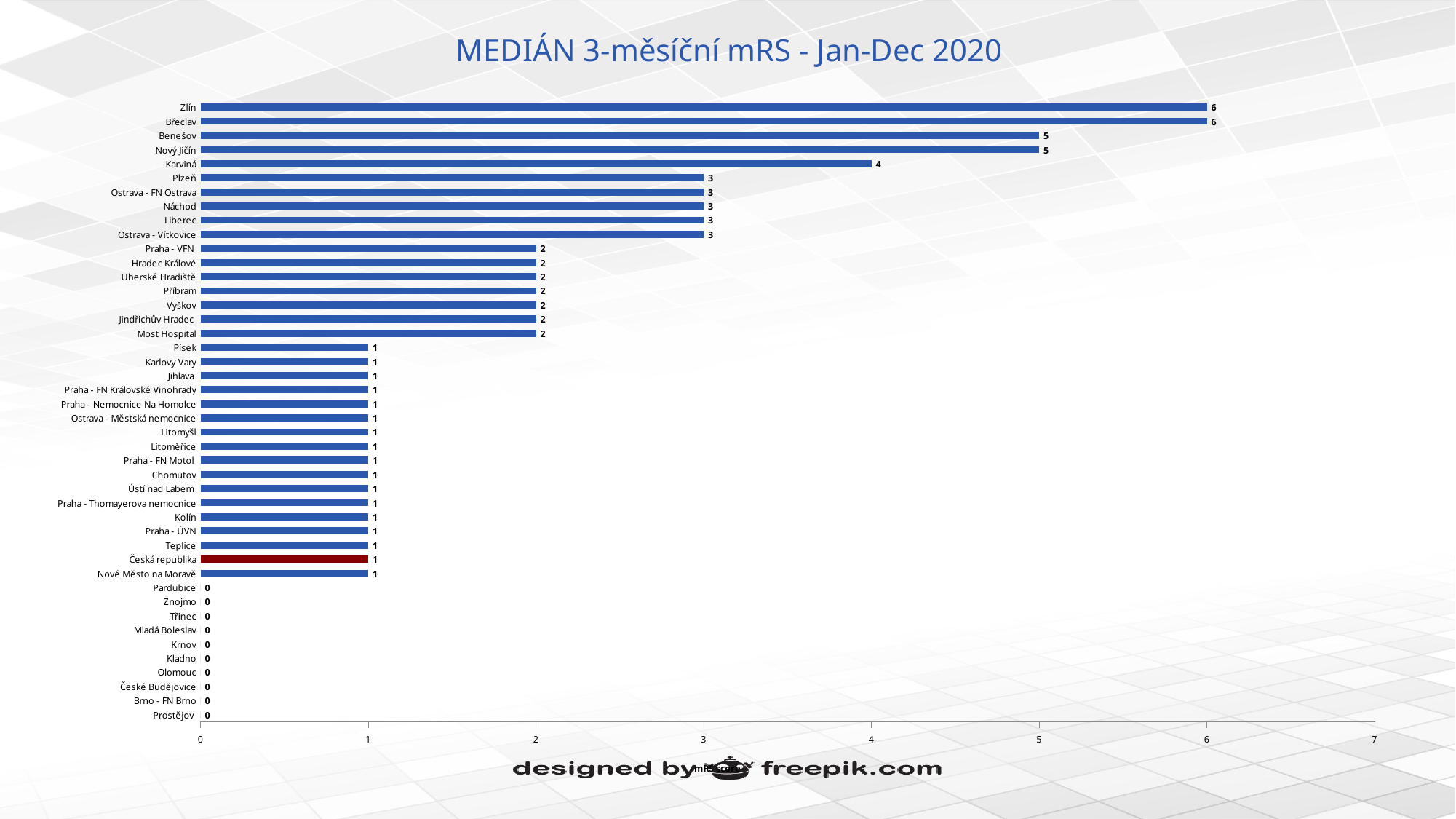
How many categories have a value of 0? 10 What is the title of the chart? MEDIÁN 3-měsíční mRS - Jan-Dec 2020 What is the difference between the values for Zlín and Plzeň? 3 What is the value for Karviná? 4 What is the value for Česká republika? 1 What is the highest value shown on the chart? 6 How many categories have a value of 6? 2 What is the value for Benešov? 5 Which has a larger value, Karviná or Liberec? Karviná What kind of chart is shown on the slide? Bar chart What is the value for Olomouc? 0 Which has a larger value, Most Hospital or Písek? Most Hospital